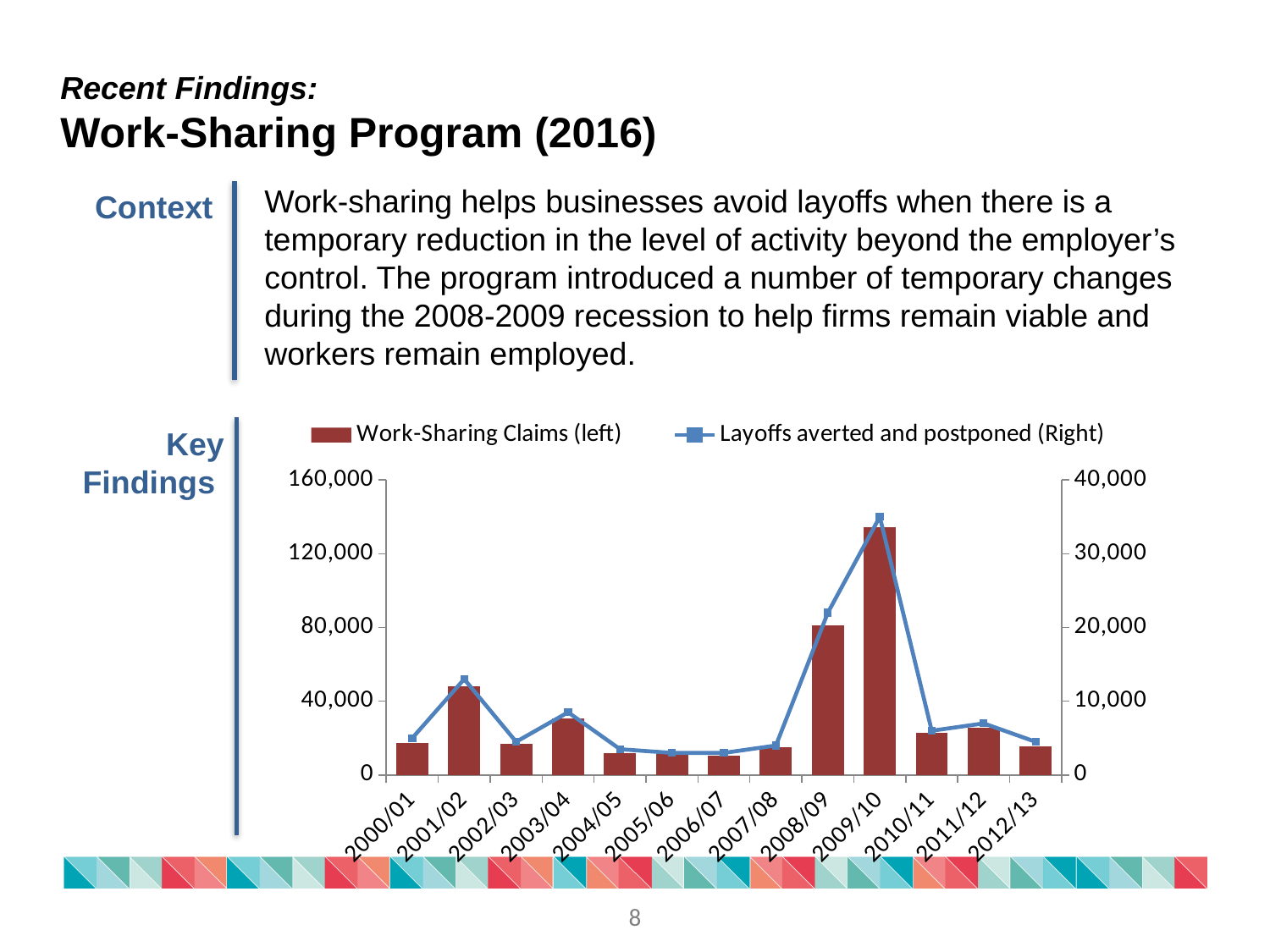
Which fiscal year has the highest value for Layoffs averted and postponed? 2009/10 Is the value of Layoffs averted and postponed for 2009/10 greater or less than 30,000? greater Is the value of Work-Sharing Claims for 2001/02 greater or less than 40,000? greater Is the value of Work-Sharing Claims for 2009/10 greater or less than 120,000? greater Which fiscal year has more Work-Sharing Claims, 2008/09 or 2001/02? 2008/09 How many fiscal years are shown on the x axis of the chart? 13 What kind of chart is shown on the slide? A combination bar and line chart How many series does the chart legend list? 2 Do Work-Sharing Claims rise or fall from 2009/10 to 2010/11? Fall Which fiscal year has the highest number of Work-Sharing Claims? 2009/10 Which series in the chart is plotted against the right axis? Layoffs averted and postponed